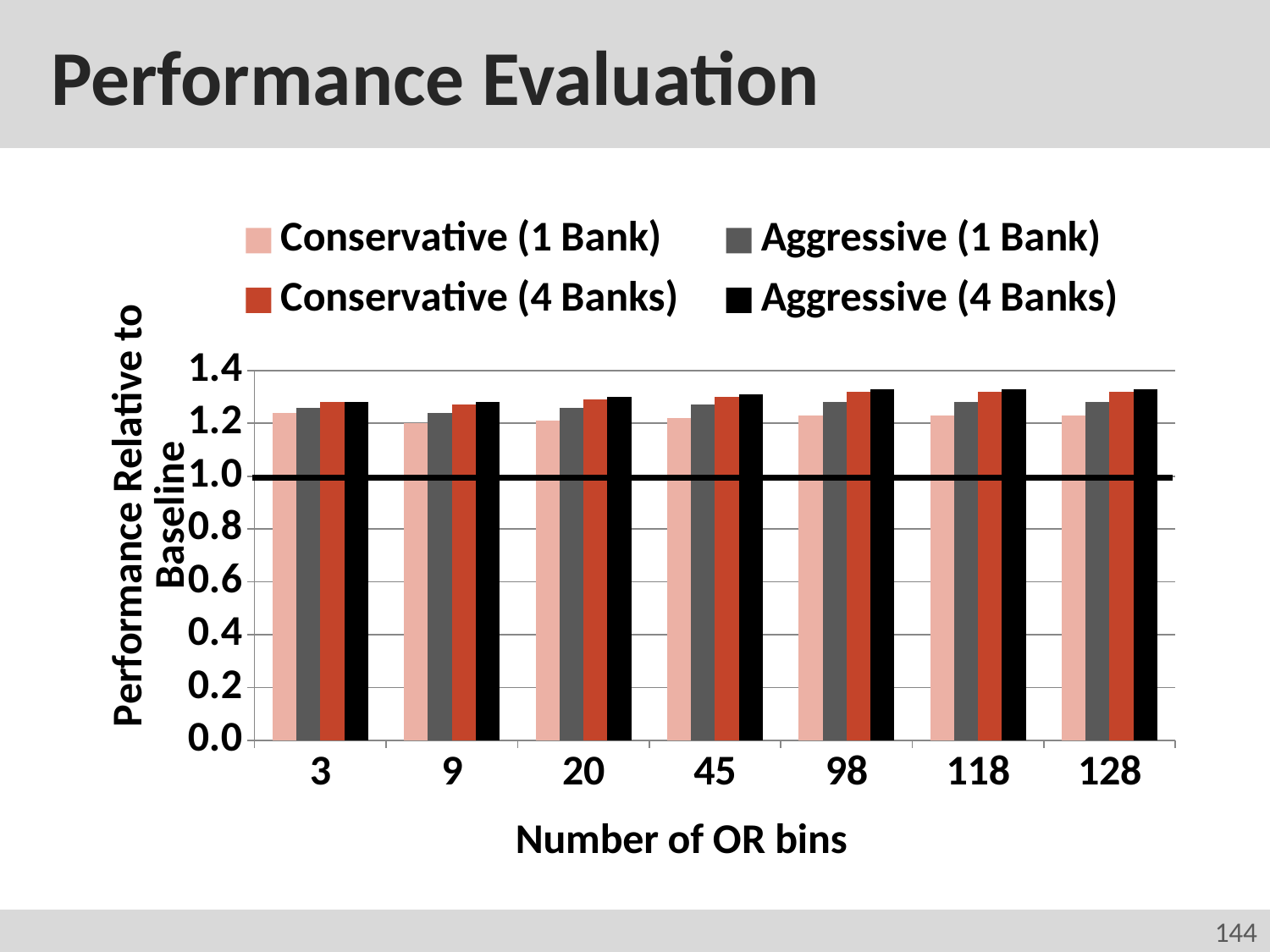
Is the value for Aggressive (1 Bank) at 45 OR bins greater or less than 1.4? less What is the title of the x axis? Number of OR bins At 9 OR bins, which is larger: Conservative (1 Bank) or Aggressive (4 Banks)? Aggressive (4 Banks) At 98 OR bins, which is larger: Aggressive (4 Banks) or Conservative (1 Bank)? Aggressive (4 Banks) How many series does the legend list? 4 At 20 OR bins, which is larger: Conservative (4 Banks) or Conservative (1 Bank)? Conservative (4 Banks) Is the value for Aggressive (4 Banks) at 128 OR bins greater or less than 1.2? greater What kind of chart is shown on the slide? bar chart Is the value for Conservative (1 Bank) at 3 OR bins greater or less than 1.0? greater What is the title of the y axis? Performance Relative to Baseline How many categories (numbers of OR bins) are shown on the x axis? 7